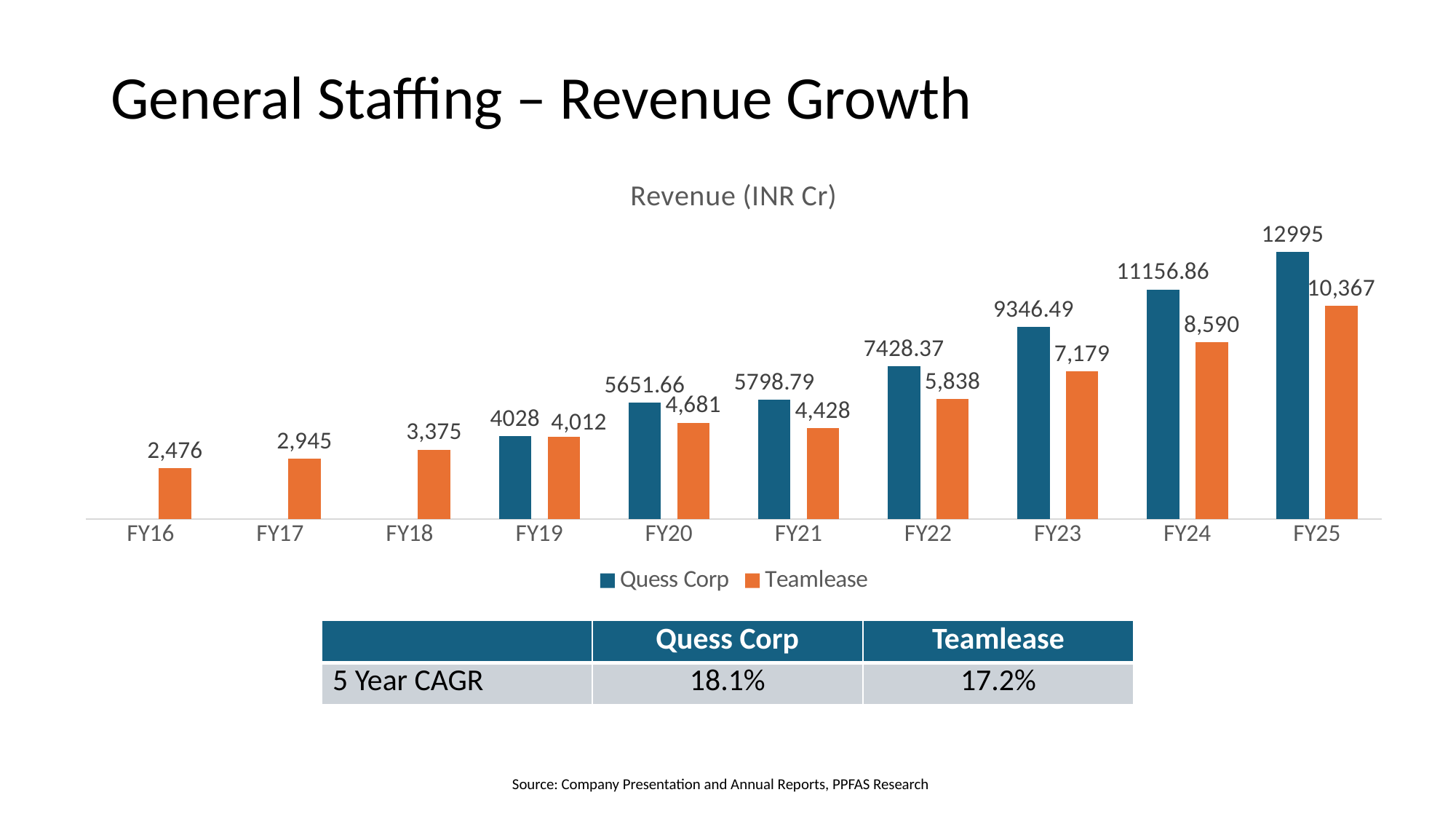
What is the title of the chart? Revenue (INR Cr) What is the difference between the Teamlease revenue in FY25 and FY24? 1,777 How many fiscal years are shown on the x axis? 10 What is the Teamlease revenue for FY23? 7,179 In which fiscal year is the Teamlease revenue highest? FY25 What is the Teamlease revenue for FY16? 2,476 Which is larger in FY21, the Quess Corp revenue or the Teamlease revenue? Quess Corp What is the Quess Corp revenue for FY22? 7428.37 What is the Quess Corp revenue for FY25? 12995 How many series does the legend list? 2 What kind of chart is shown on the slide? Bar chart In which fiscal year is the Teamlease revenue lowest? FY16